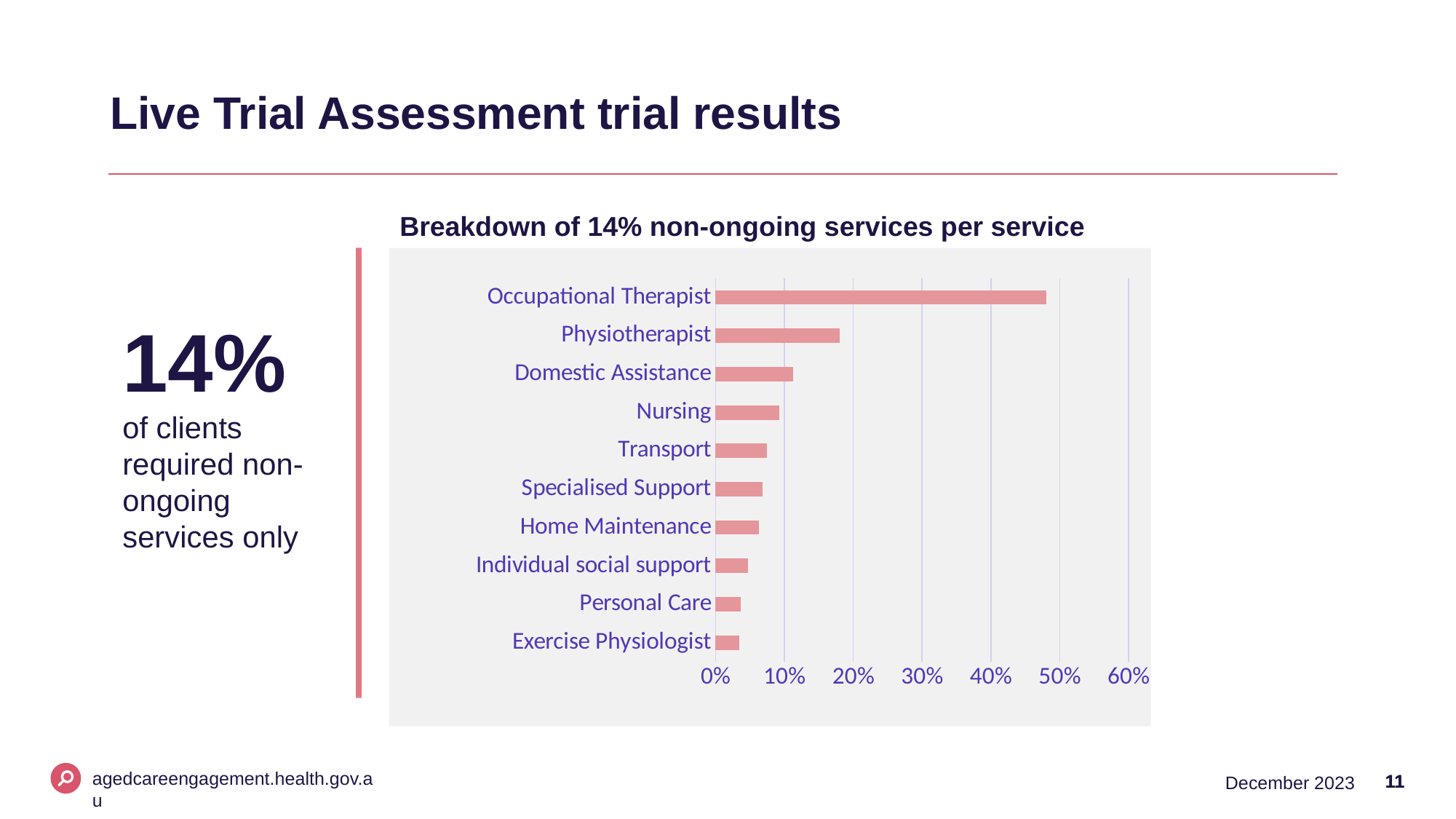
Which is larger, the value for Physiotherapist or the value for Nursing? Physiotherapist What is the title of the chart? Breakdown of 14% non-ongoing services per service Is the value for Occupational Therapist greater or less than 40%? greater Is the value for Domestic Assistance greater or less than 10%? greater What is the highest value shown on the x axis of the chart? 60% Is the value for Physiotherapist greater or less than 20%? less How many service categories are plotted in the chart? 10 Which service has the highest value in the chart? Occupational Therapist What kind of chart is shown on the slide? bar chart Which is larger, the value for Transport or the value for Occupational Therapist? Occupational Therapist